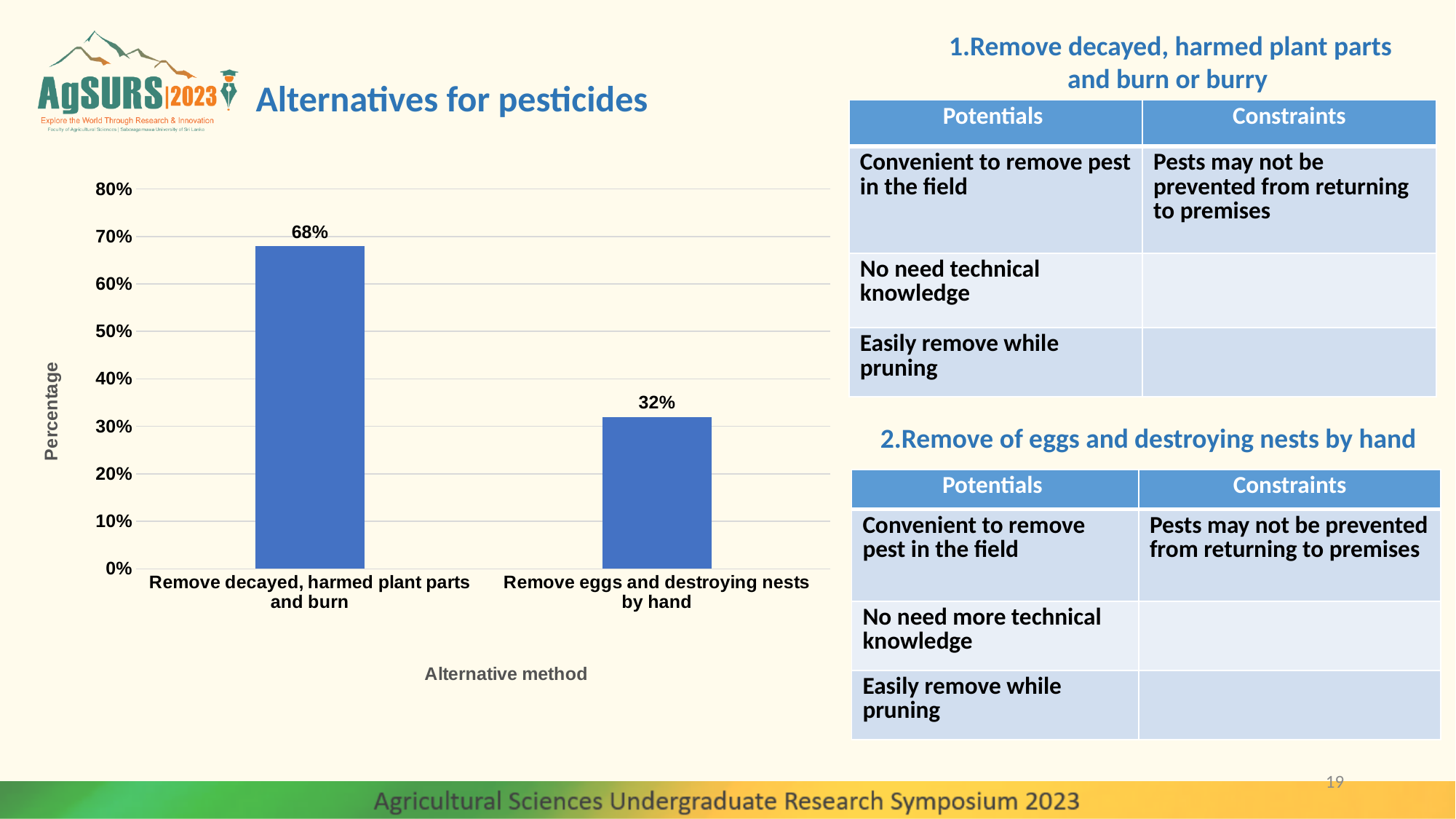
Which alternative method has the lowest percentage? Remove eggs and destroying nests by hand Which has a larger percentage: "Remove decayed, harmed plant parts and burn" or "Remove eggs and destroying nests by hand"? Remove decayed, harmed plant parts and burn Which alternative method has the highest percentage? Remove decayed, harmed plant parts and burn Is the value for "Remove eggs and destroying nests by hand" greater or less than 40%? less What type of chart is used to show the alternatives for pesticides? Bar chart What percentage is shown for "Remove eggs and destroying nests by hand"? 32% What is the label of the horizontal axis of the chart? Alternative method Is the value for "Remove decayed, harmed plant parts and burn" greater or less than 60%? greater How many alternative methods are plotted in the chart? 2 What percentage is shown for "Remove decayed, harmed plant parts and burn"? 68% What is the difference in percentage between "Remove decayed, harmed plant parts and burn" and "Remove eggs and destroying nests by hand"? 36% What is the label of the vertical axis of the chart? Percentage